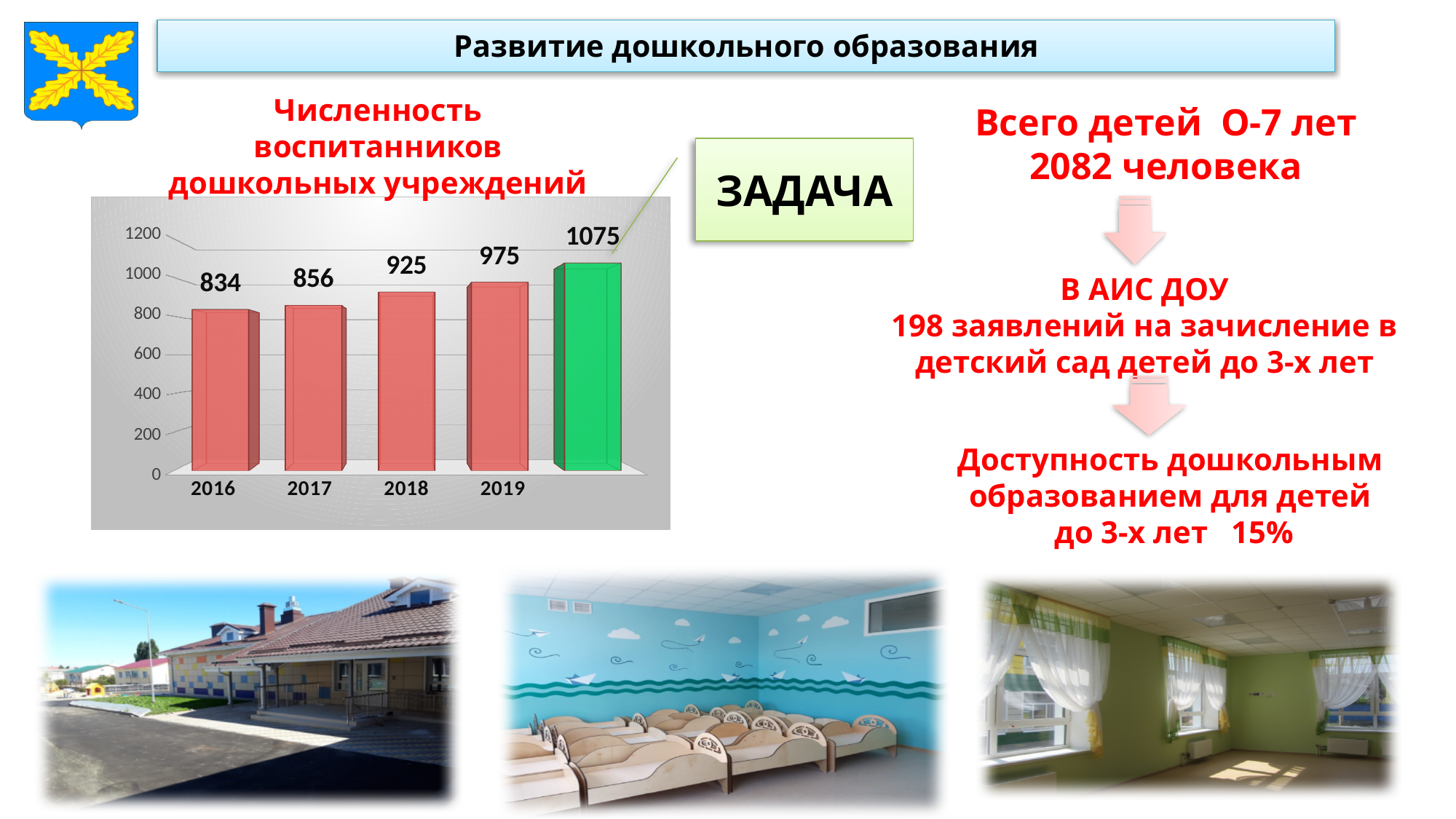
Is the value for 2019 greater or less than 1000? less What is the value for 2016 in the chart? 834 What value is labelled on the green bar in the chart? 1075 Which labelled year has the highest value in the chart? 2019 Which is larger, the value for 2017 or the value for 2018? 2018 What is the value for 2017 in the chart? 856 What is the value for 2018 in the chart? 925 What is the value for 2019 in the chart? 975 Do the values rise or fall from 2016 to 2019? rise What is the difference between the values for 2019 and 2016? 141 Which labelled year has the lowest value in the chart? 2016 What type of chart is shown on the slide? bar chart